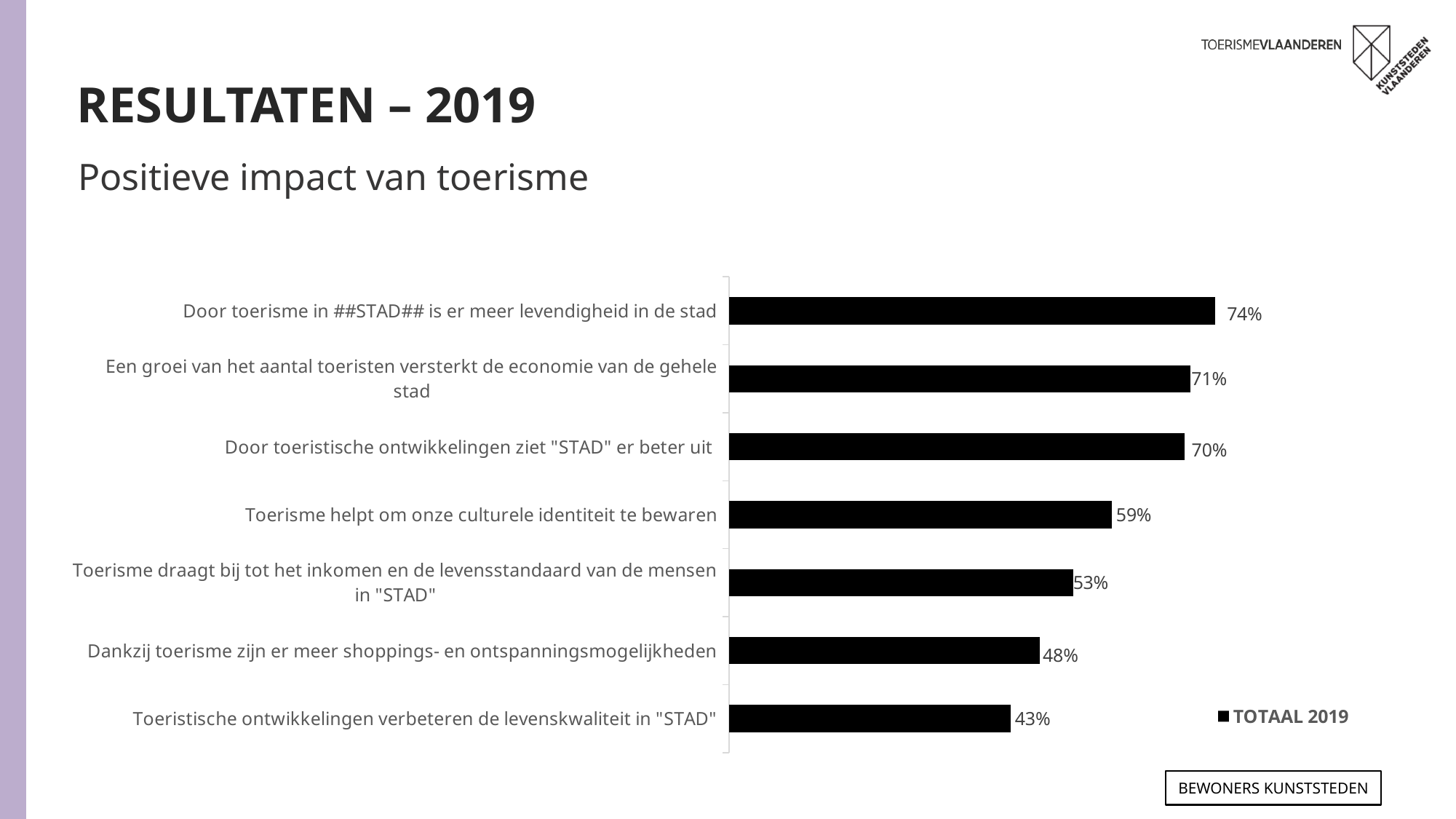
How many series does the legend list? 1 Which category has the highest value? Door toerisme in ##STAD## is er meer levendigheid in de stad What is the value for "Dankzij toerisme zijn er meer shoppings- en ontspanningsmogelijkheden"? 48% What is the value for "Toerisme helpt om onze culturele identiteit te bewaren"? 59% What kind of chart is shown on the slide? Bar chart Which is larger: the value for "Door toeristische ontwikkelingen ziet "STAD" er beter uit" or the value for "Toerisme draagt bij tot het inkomen en de levensstandaard van de mensen in "STAD""? Door toeristische ontwikkelingen ziet "STAD" er beter uit What is the difference between the values for "Een groei van het aantal toeristen versterkt de economie van de gehele stad" and "Toerisme helpt om onze culturele identiteit te bewaren"? 12% How many categories are shown in the chart? 7 What is the difference between the values for "Door toerisme in ##STAD## is er meer levendigheid in de stad" and "Toeristische ontwikkelingen verbeteren de levenskwaliteit in "STAD""? 31% What is the value for "Door toerisme in ##STAD## is er meer levendigheid in de stad"? 74% Which category has the lowest value? Toeristische ontwikkelingen verbeteren de levenskwaliteit in "STAD" What is the value for "Toerisme draagt bij tot het inkomen en de levensstandaard van de mensen in "STAD""? 53%